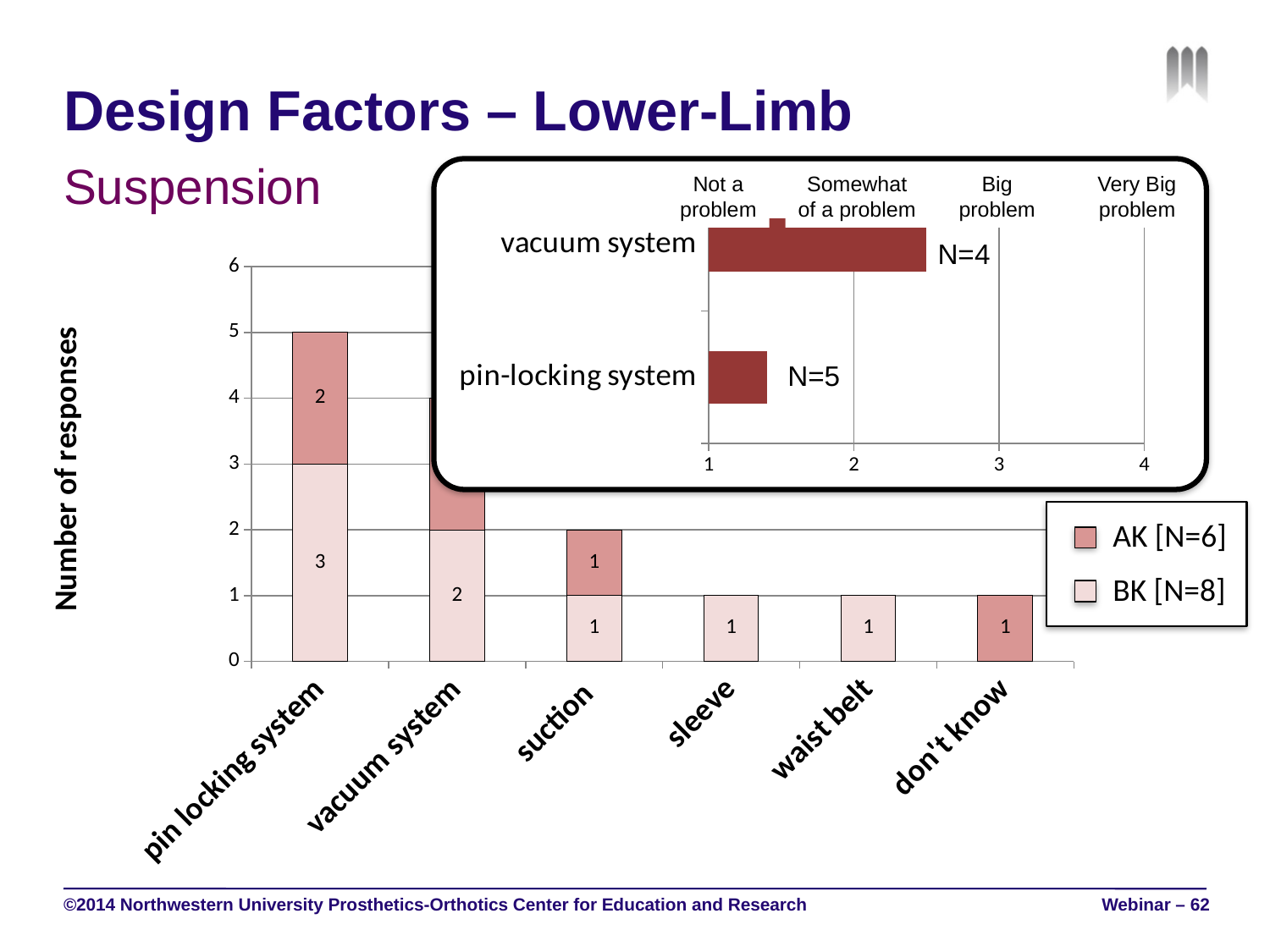
In the main bar chart, how many series does the legend list? 2 In the main bar chart, what is the BK value for pin locking system? 3 In the main bar chart, what is the total number of responses for pin locking system? 5 In the main bar chart, what is the total number of responses for suction? 2 In the main bar chart, what is the BK value for sleeve? 1 In the main bar chart, what is the AK value for don't know? 1 In the inset chart, is the value for vacuum system greater or less than 2? greater In the inset chart, which has the larger value, vacuum system or pin-locking system? vacuum system In the main bar chart, what is the difference between the BK value and the AK value for pin locking system? 1 What kind of chart is the main chart on the slide? stacked bar chart In the main bar chart, how many suspension categories are shown on the x axis? 6 In the main bar chart, what is the AK value for pin locking system? 2